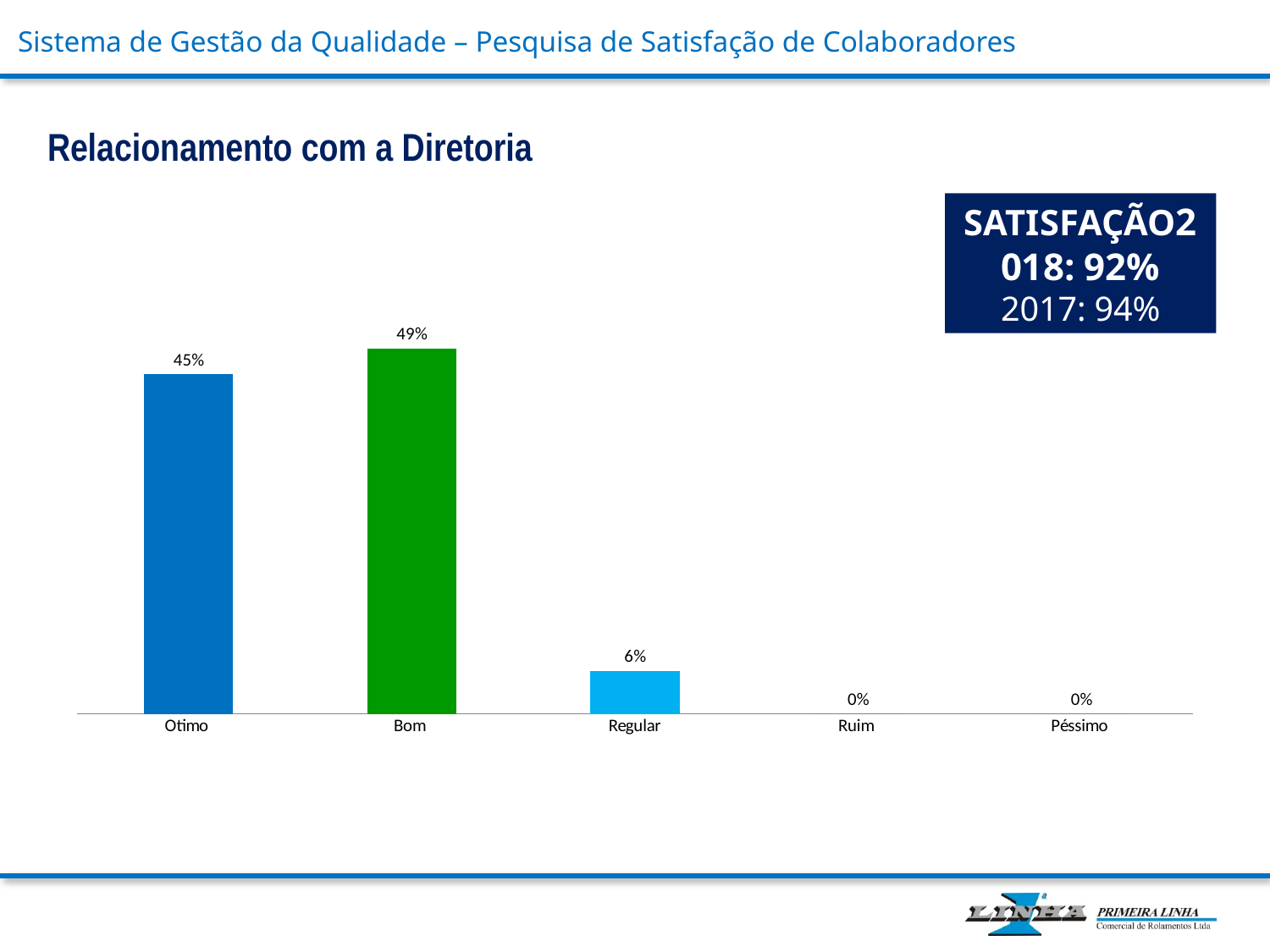
How many categories are shown on the x axis? 5 Which category has the highest value? Bom What is the value for Ruim? 0% What is the value for Bom? 49% What kind of chart is shown on the slide? Bar chart What is the value for Regular? 6% What colour is the bar for Bom? Green Which is larger, the value for Otimo or the value for Regular? Otimo What is the difference between the values for Otimo and Regular? 39% What is the value for Otimo? 45% What is the combined value of Otimo and Bom? 94% What is the difference between the values for Bom and Otimo? 4%